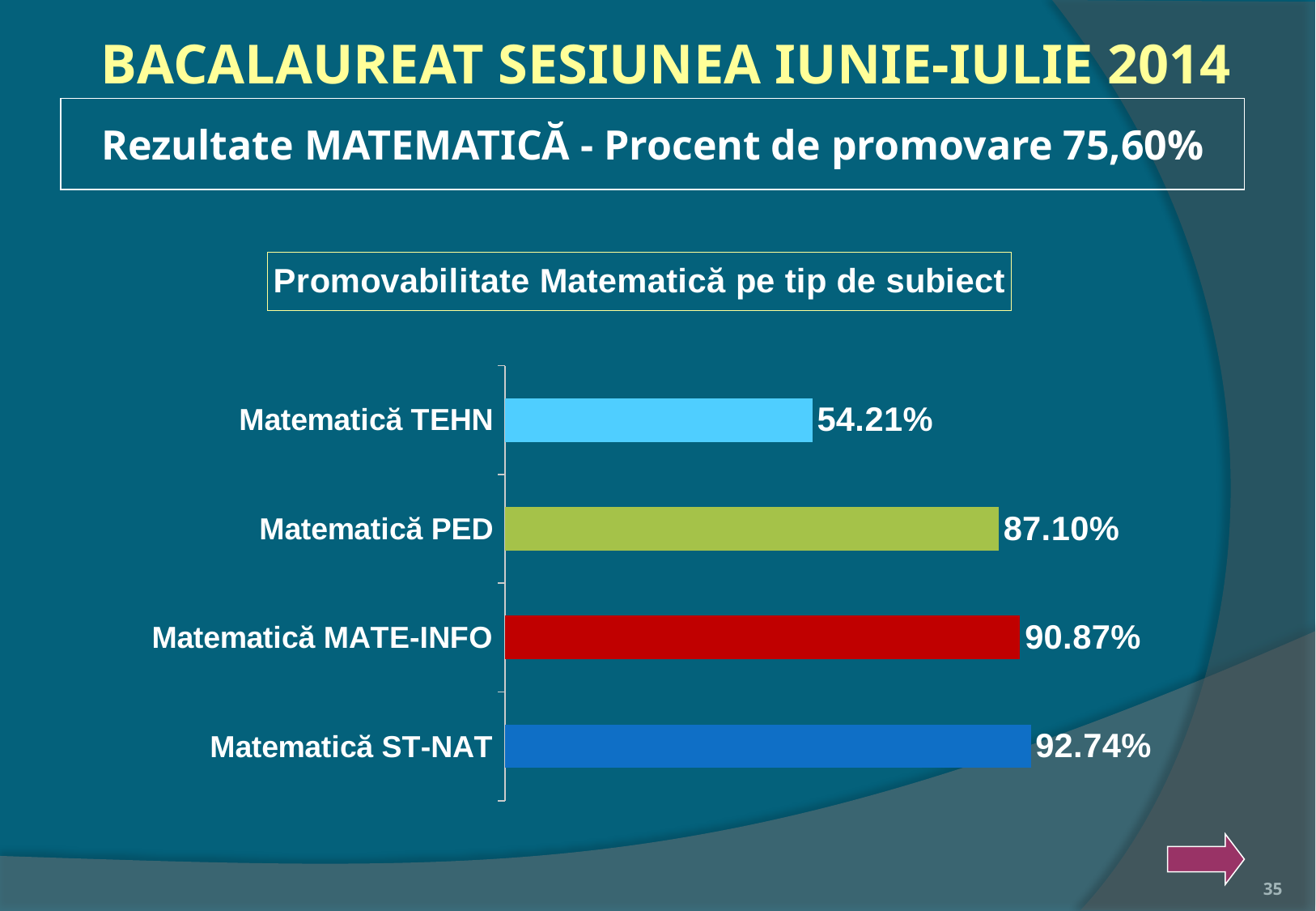
What is the pass rate for Matematică TEHN? 54.21% What is the pass rate for Matematică MATE-INFO? 90.87% Which subject type has the highest pass rate? Matematică ST-NAT What is the difference between the pass rates of Matematică ST-NAT and Matematică TEHN? 38.53% What is the title of the chart? Promovabilitate Matematică pe tip de subiect What kind of chart is shown on the slide? Bar chart What is the difference between the pass rates of Matematică MATE-INFO and Matematică PED? 3.77% What is the pass rate for Matematică PED? 87.10% Which subject type has the lowest pass rate? Matematică TEHN Which has a higher pass rate, Matematică PED or Matematică TEHN? Matematică PED How many subject types are shown in the chart? 4 What is the pass rate for Matematică ST-NAT? 92.74%